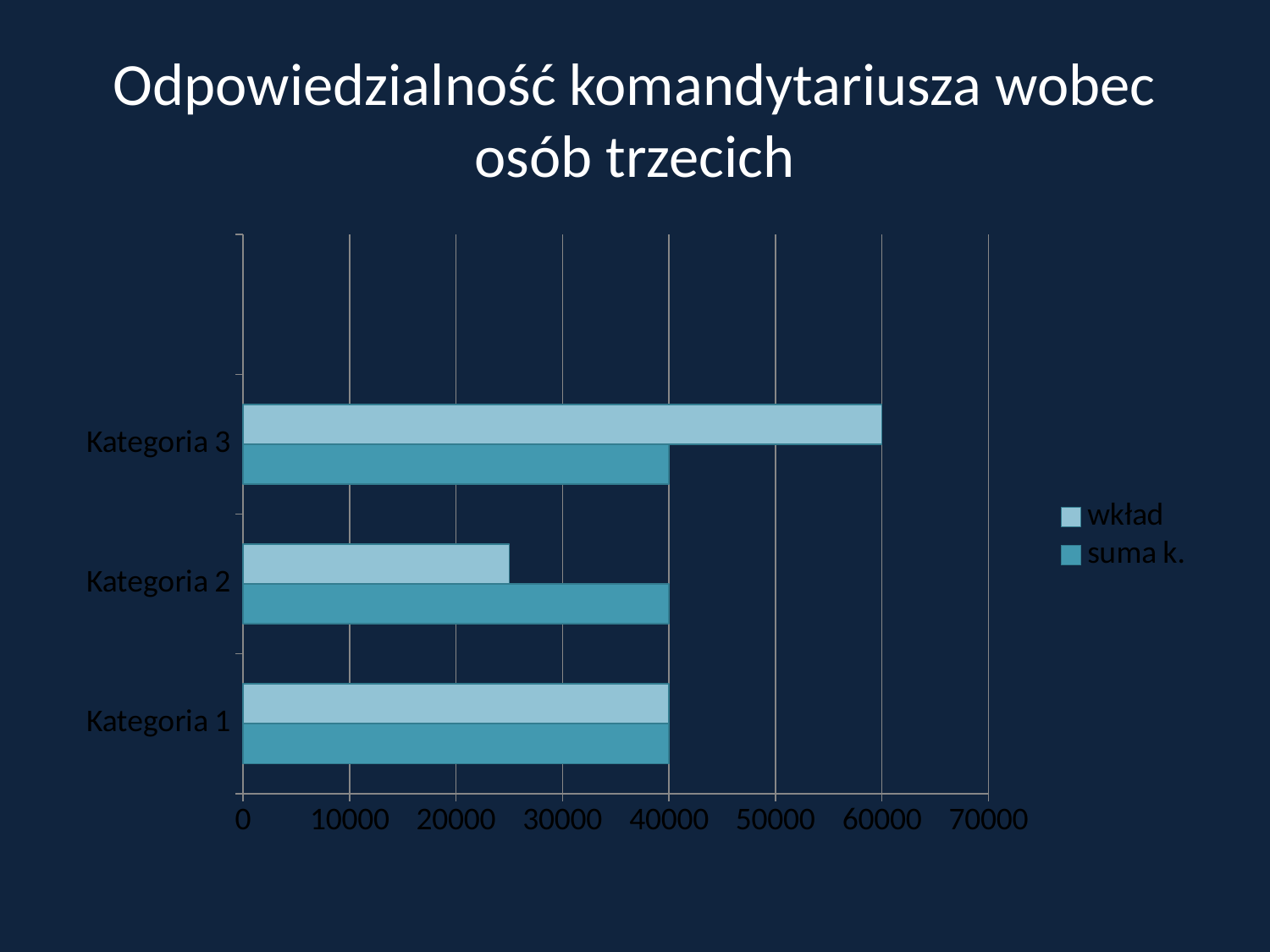
For Kategoria 3, which series has the larger value, wkład or suma k.? wkład Which category has the highest wkład value? Kategoria 3 What is the value of wkład for Kategoria 1? 40000 Is the wkład value for Kategoria 2 greater or less than 30000? less What is the title of the slide containing the chart? Odpowiedzialność komandytariusza wobec osób trzecich How many categories are shown on the chart? 3 For Kategoria 3, what is the difference between the wkład value and the suma k. value? 20000 What is the value of suma k. for Kategoria 1? 40000 How many series does the legend list? 2 Which category has the lowest wkład value? Kategoria 2 What is the value of wkład for Kategoria 3? 60000 What type of chart is shown on the slide? bar chart